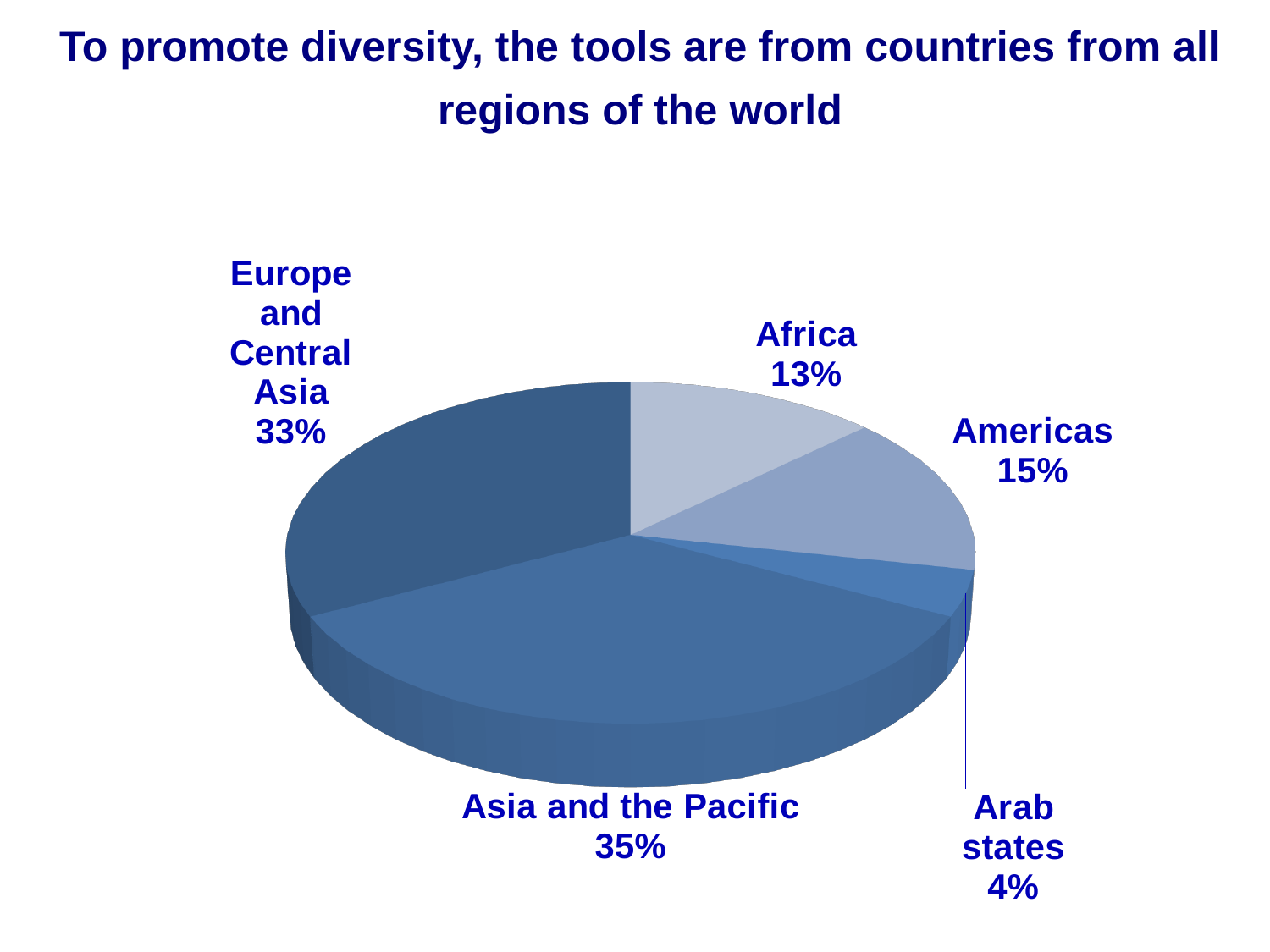
What percentage is shown for Europe and Central Asia? 33% What is the difference in percentage points between the Americas and Africa? 2 What percentage is shown for Africa? 13% Which is larger, the share for the Americas or the share for Africa? Americas What share of the pie does Asia and the Pacific hold? 35% What kind of chart is shown on the slide? Pie chart How many regions are shown in the pie chart? 5 What is the value for Arab states? 4% Which region has the largest slice of the pie? Asia and the Pacific What is the difference in percentage points between Asia and the Pacific and Europe and Central Asia? 2 Which region has the smallest slice of the pie? Arab states What is the combined share of Africa and the Americas? 28%